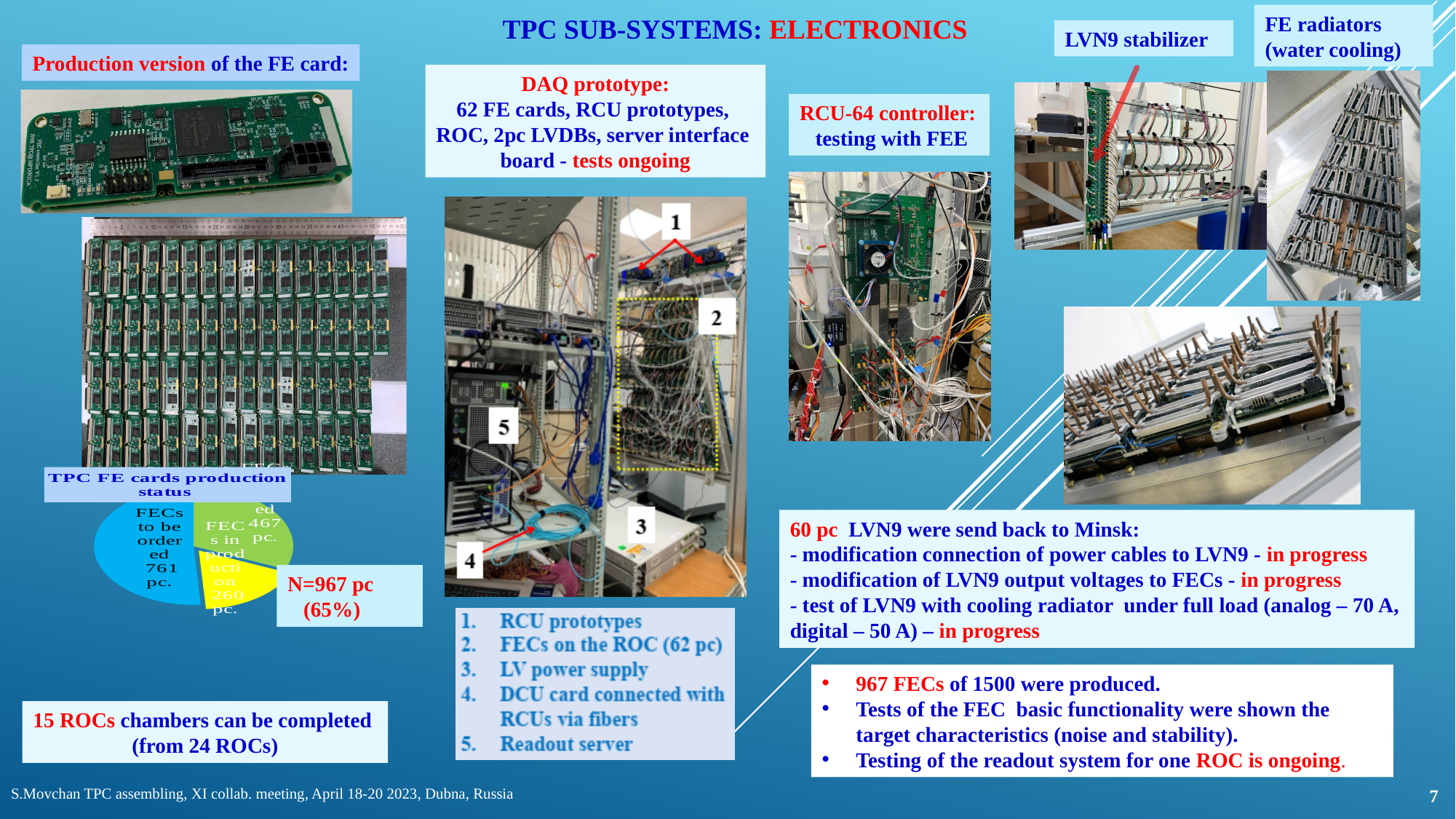
In the 'TPC FE cards production status' pie chart, what colour is the FECs to be ordered slice? blue In the 'TPC FE cards production status' pie chart, which is larger: FECs to be ordered or FECs in production? FECs to be ordered What is the title of the pie chart on the slide? TPC FE cards production status What kind of chart is the 'TPC FE cards production status' chart? pie chart In the 'TPC FE cards production status' pie chart, what value is shown on the green slice? 467 pc. In the 'TPC FE cards production status' pie chart, what is the difference between the green slice value and FECs in production? 207 pc. How many slices does the 'TPC FE cards production status' pie chart have? 3 In the 'TPC FE cards production status' pie chart, which category has the largest slice? FECs to be ordered In the 'TPC FE cards production status' pie chart, what value is shown for FECs in production? 260 pc. In the 'TPC FE cards production status' pie chart, what value is shown for FECs to be ordered? 761 pc. In the 'TPC FE cards production status' pie chart, which category has the smallest slice? FECs in production In the 'TPC FE cards production status' pie chart, what is the difference between FECs to be ordered and FECs in production? 501 pc.